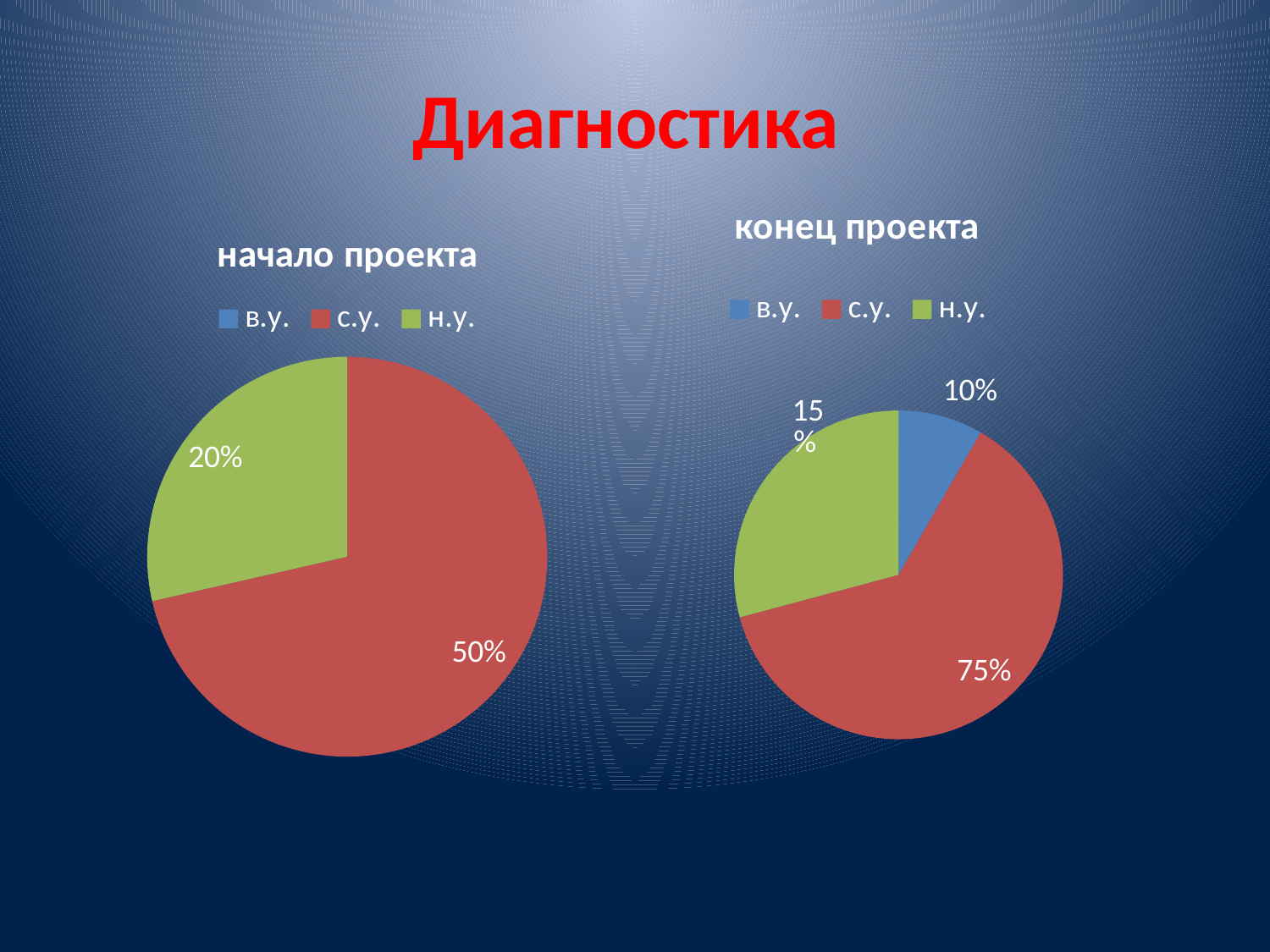
How many slices with data labels does the "конец проекта" chart have? 3 What type of chart is the "конец проекта" chart? Pie chart In the "начало проекта" chart, which is larger, с.у. or н.у.? с.у. In the "начало проекта" chart, what is the value for н.у.? 20% In the "начало проекта" chart, what is the value for с.у.? 50% In the "конец проекта" chart, what is the value for с.у.? 75% In the "конец проекта" chart, what is the value for н.у.? 15% In the "конец проекта" chart, which category has the largest slice? с.у. In the "конец проекта" chart, what is the difference between the values for с.у. and в.у.? 65% How many entries does the legend of the "начало проекта" chart list? 3 In the "конец проекта" chart, what is the value for в.у.? 10% In the "конец проекта" chart, which category has the smallest slice? в.у.